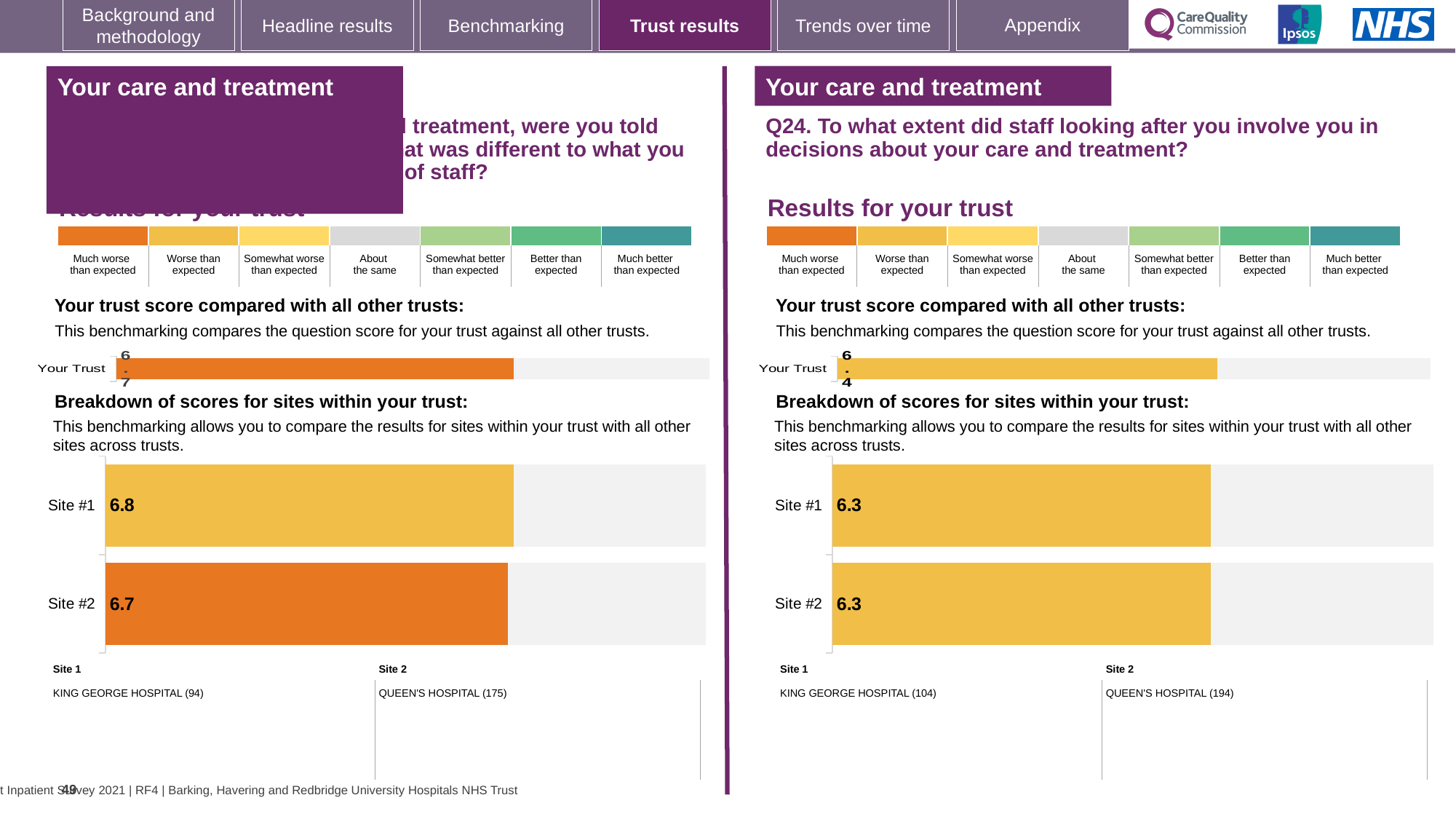
On the left-hand site breakdown chart, what is the score for Site #1? 6.8 On the left-hand site breakdown chart, what is the difference between the Site #1 and Site #2 scores? 0.1 On the left-hand site breakdown chart, which site has the higher score? Site #1 On the right-hand (Q24) 'Your trust score compared with all other trusts' chart, what is the score for Your Trust? 6.4 On the left-hand 'Your trust score compared with all other trusts' chart, what is the score for Your Trust? 6.7 What type of chart is used for the site breakdown on the right-hand (Q24) side? Bar chart On the left-hand site breakdown chart, is the Site #2 bar coloured orange or yellow? Orange On the right-hand (Q24) site breakdown chart, how many sites are shown? 2 On the right-hand (Q24) site breakdown chart, what is the score for Site #2? 6.3 On the right-hand (Q24) site breakdown chart, which hospital is Site 2? QUEEN'S HOSPITAL (194) On the left-hand site breakdown chart, what is the score for Site #2? 6.7 On the right-hand (Q24) site breakdown chart, what is the score for Site #1? 6.3